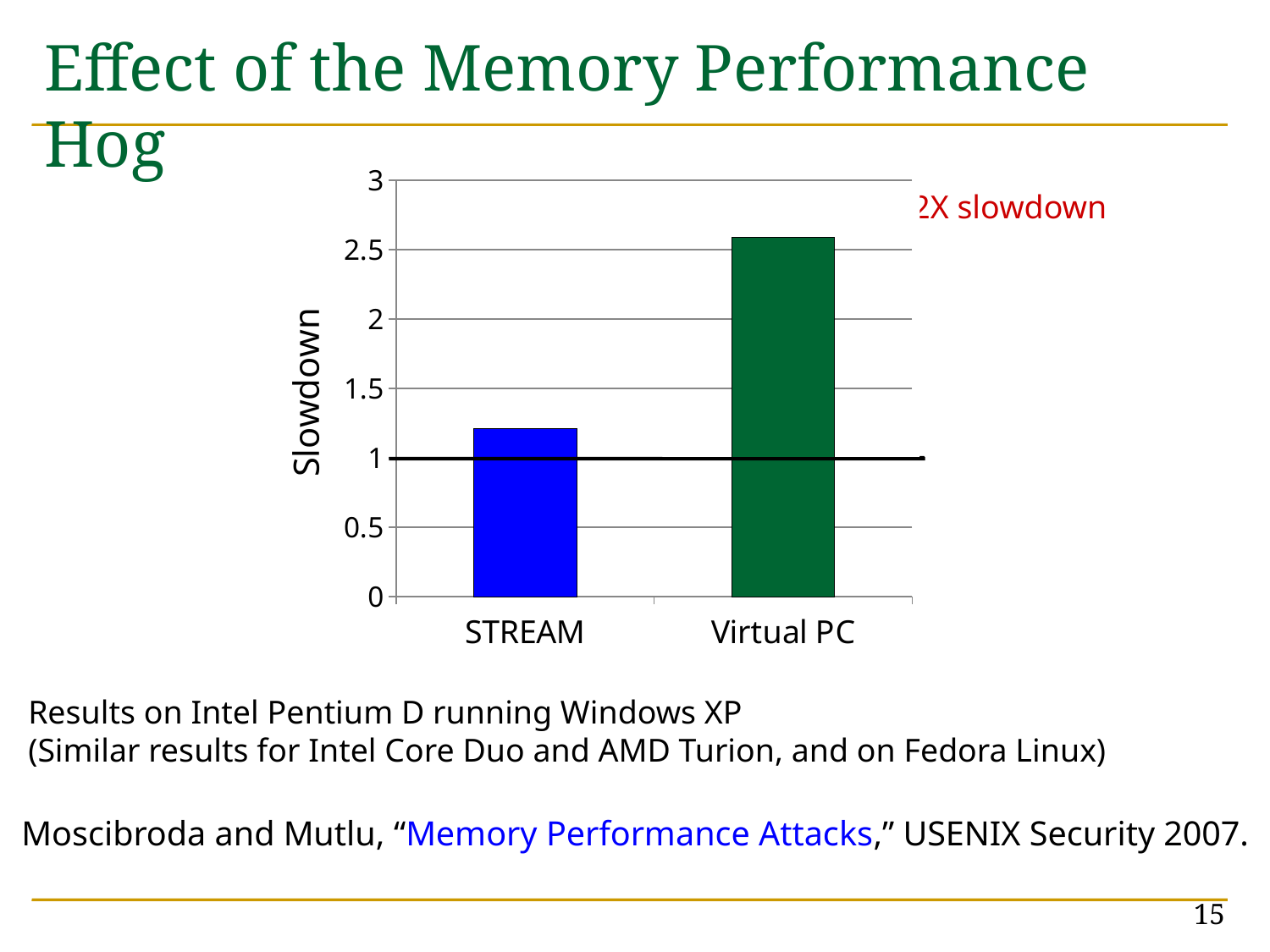
Which has a larger slowdown, STREAM or Virtual PC? Virtual PC How many categories are plotted on the x axis of the chart? 2 Is the slowdown for Virtual PC greater or less than 2? greater Is the slowdown for STREAM greater or less than 1? greater Is the slowdown for Virtual PC greater or less than 3? less What kind of chart is shown on the slide? bar chart Which category has the lowest slowdown? STREAM What is the label of the y axis of the chart? Slowdown What colour is the bar for Virtual PC? green Which category has the highest slowdown? Virtual PC